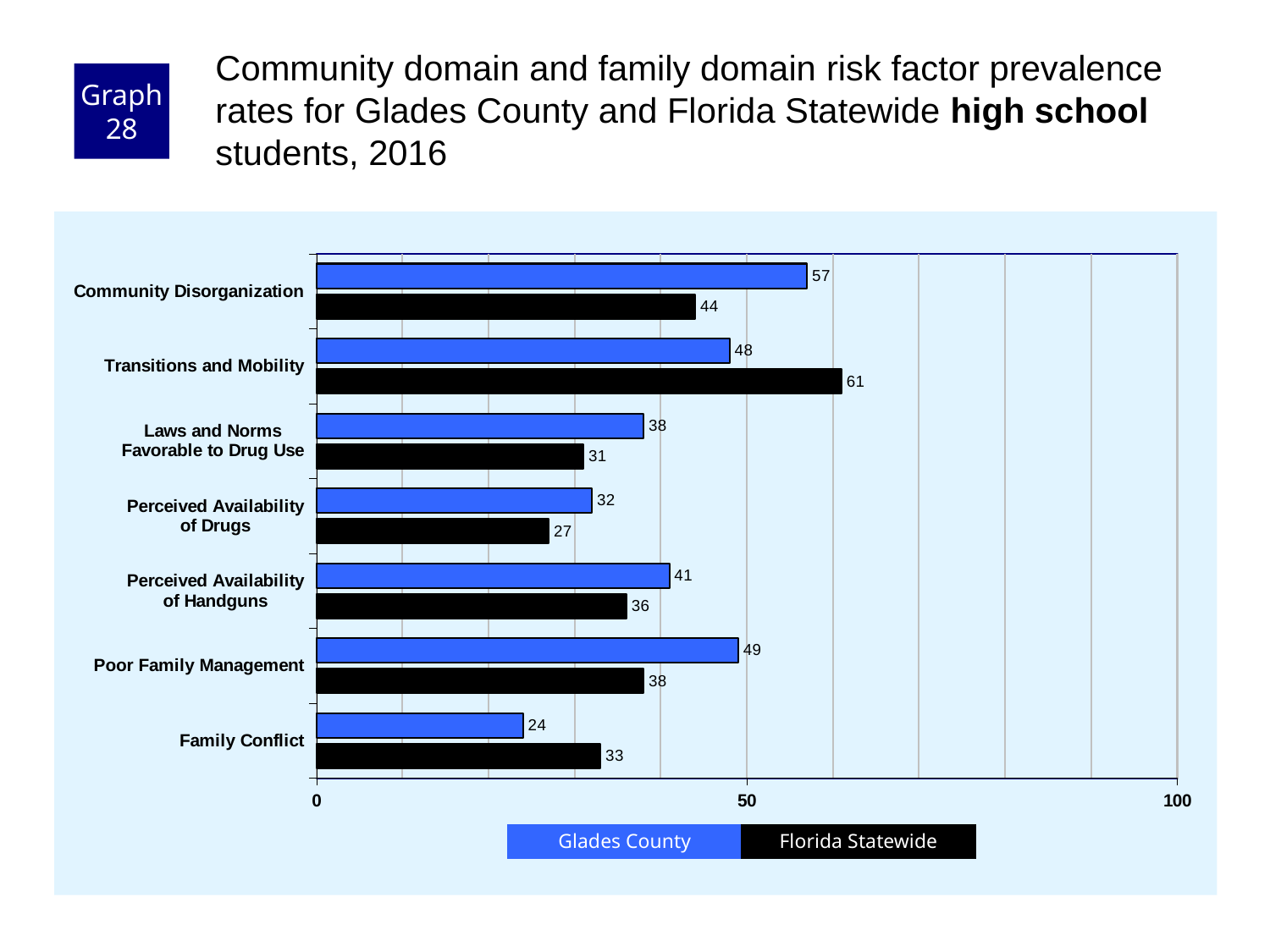
Which risk factor has the highest Glades County value? Community Disorganization Which is larger for Family Conflict: the Glades County value or the Florida Statewide value? Florida Statewide What is the difference between the Glades County and Florida Statewide values for Poor Family Management? 11 What is the Glades County value for Family Conflict? 24 Which risk factor has the lowest Florida Statewide value? Perceived Availability of Drugs What kind of chart is shown on the slide? bar chart Is the Glades County value for Transitions and Mobility greater or less than 50? less Which colour represents Florida Statewide in the chart? black What is the Florida Statewide value for Transitions and Mobility? 61 What is the Glades County value for Community Disorganization? 57 How many series does the legend list? 2 How many risk factors are shown on the chart? 7